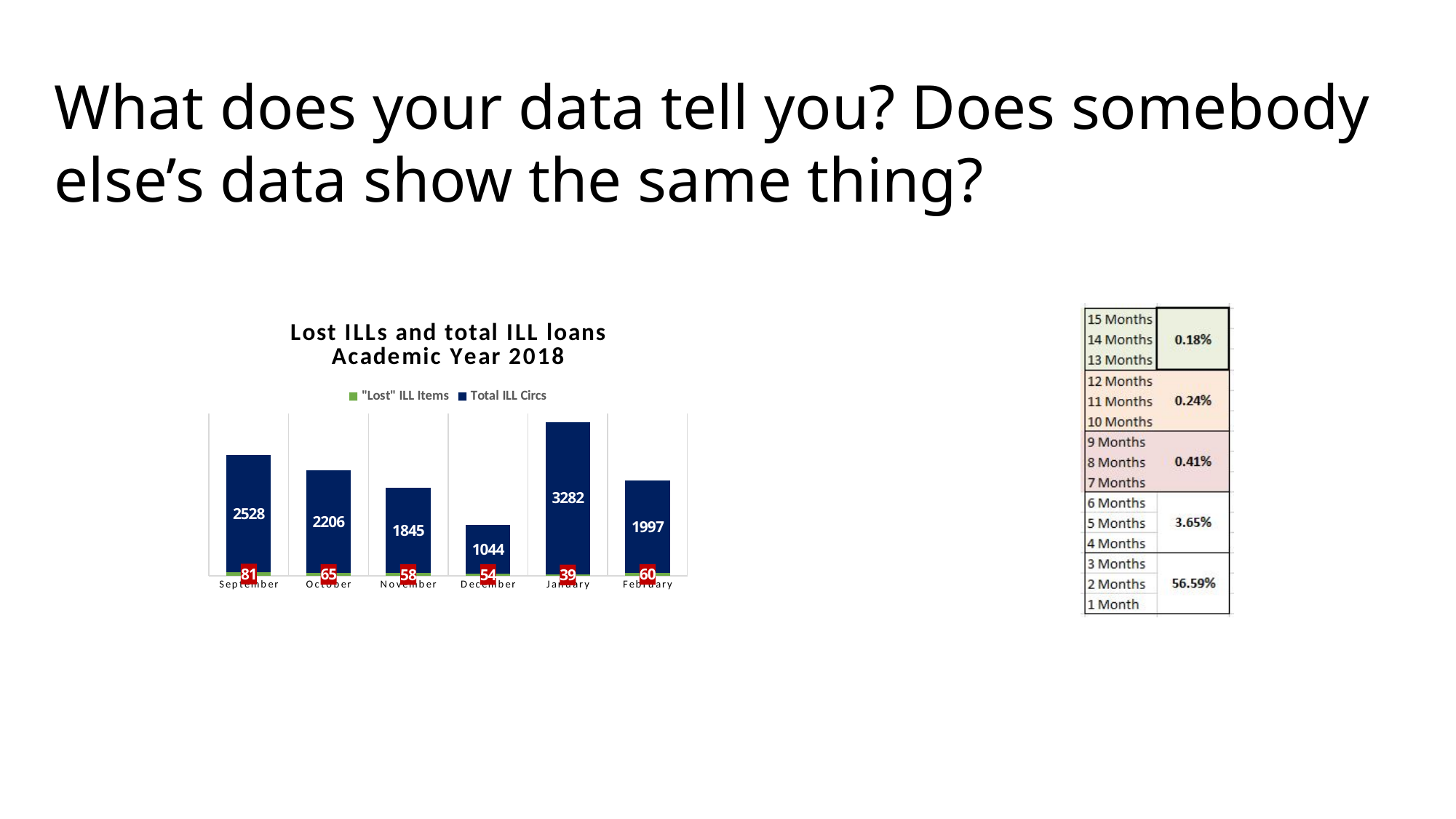
What kind of chart is shown on the slide? Bar chart Which is larger, Total ILL Circs for October or for February? October What is the total of the stacked bar for November? 1903 What is the value of "Lost" ILL Items for September? 81 How many months are shown on the x axis of the chart? 6 What is the title of the chart? Lost ILLs and total ILL loans Academic Year 2018 What is the value of Total ILL Circs for January? 3282 Which month has the lowest "Lost" ILL Items value? January How many series does the chart legend list? 2 What is the difference between Total ILL Circs in January and December? 2238 What is the value of Total ILL Circs for December? 1044 Which month has the highest Total ILL Circs? January